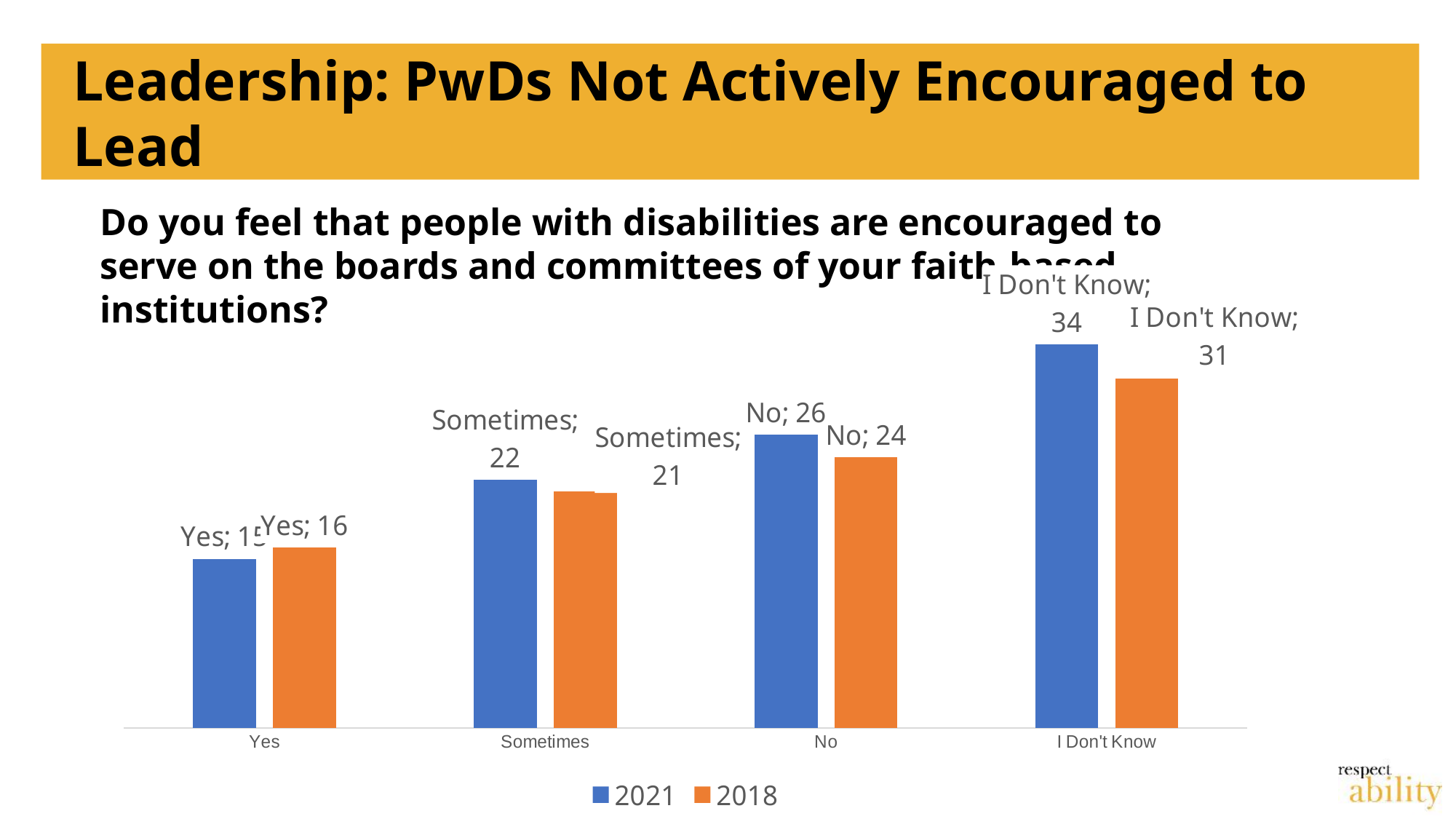
What is the value for "Sometimes" in the 2018 series? 21 Which category has the highest value in the 2021 series? I Don't Know What is the difference between the 2021 and 2018 values for "I Don't Know"? 3 What kind of chart is shown on the slide? Bar chart How many categories are shown on the x axis of the chart? 4 How many series does the legend list? 2 What is the value for "Yes" in the 2018 series? 16 What is the value for "No" in the 2018 series? 24 For "Sometimes", which series has the larger value, 2021 or 2018? 2021 Which category has the lowest value in the 2018 series? Yes What is the value for "I Don't Know" in the 2021 series? 34 What is the difference between the 2021 and 2018 values for "No"? 2